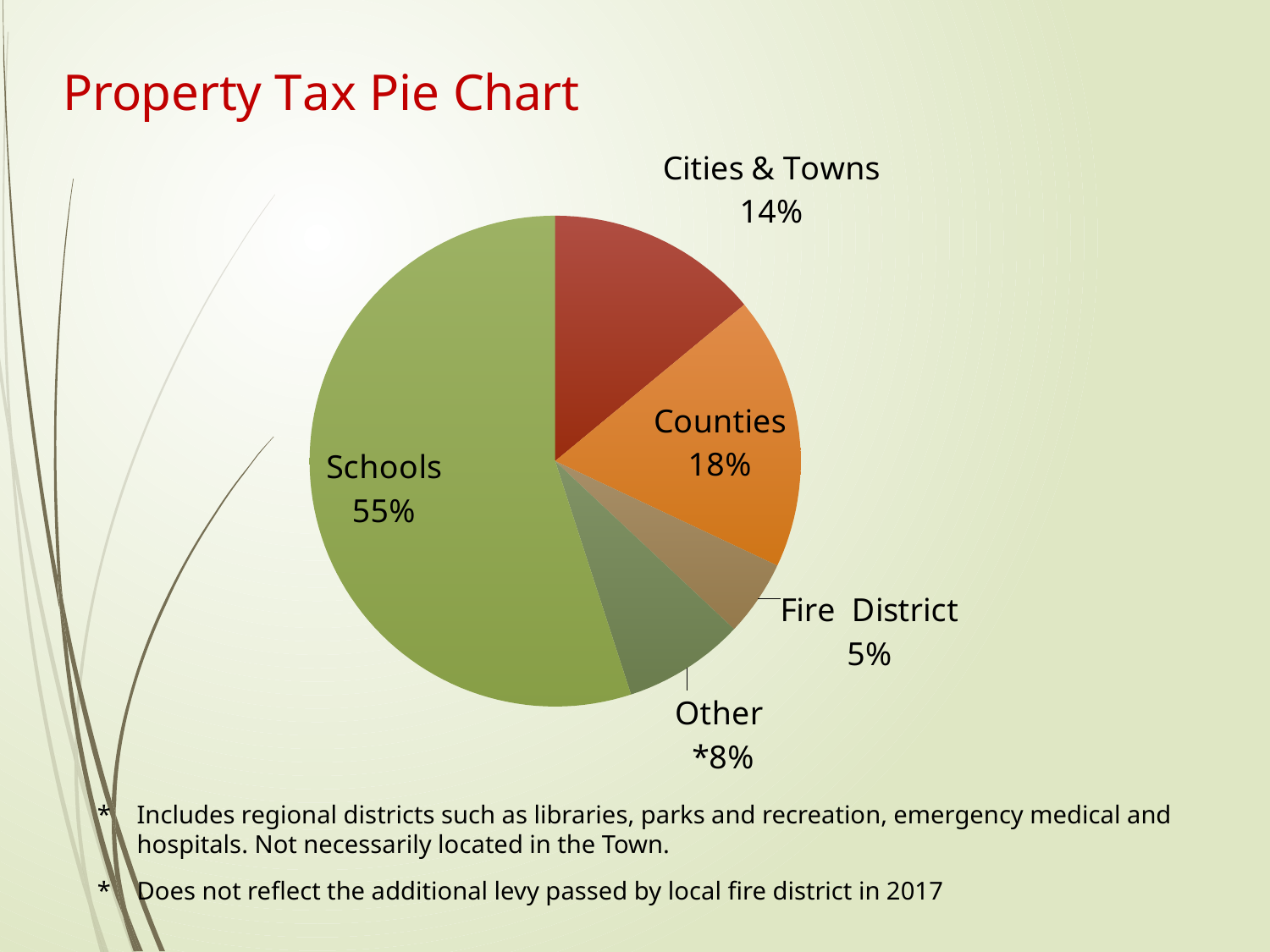
How many slices does the pie chart have? 5 Which category has the largest slice of the pie chart? Schools What percentage of the pie chart is labelled Cities & Towns? 14% What share of the property tax pie chart goes to Schools? 55% What percentage of the pie chart is labelled Counties? 18% What kind of chart is shown on the slide? Pie chart What percentage of the pie chart is labelled Fire District? 5% What percentage is shown for the Other slice? *8% What is the title of the slide containing the pie chart? Property Tax Pie Chart Which is larger, the Counties slice or the Cities & Towns slice? Counties What is the difference in percentage points between the Schools slice and the Counties slice? 37 Which category has the smallest slice of the pie chart? Fire District